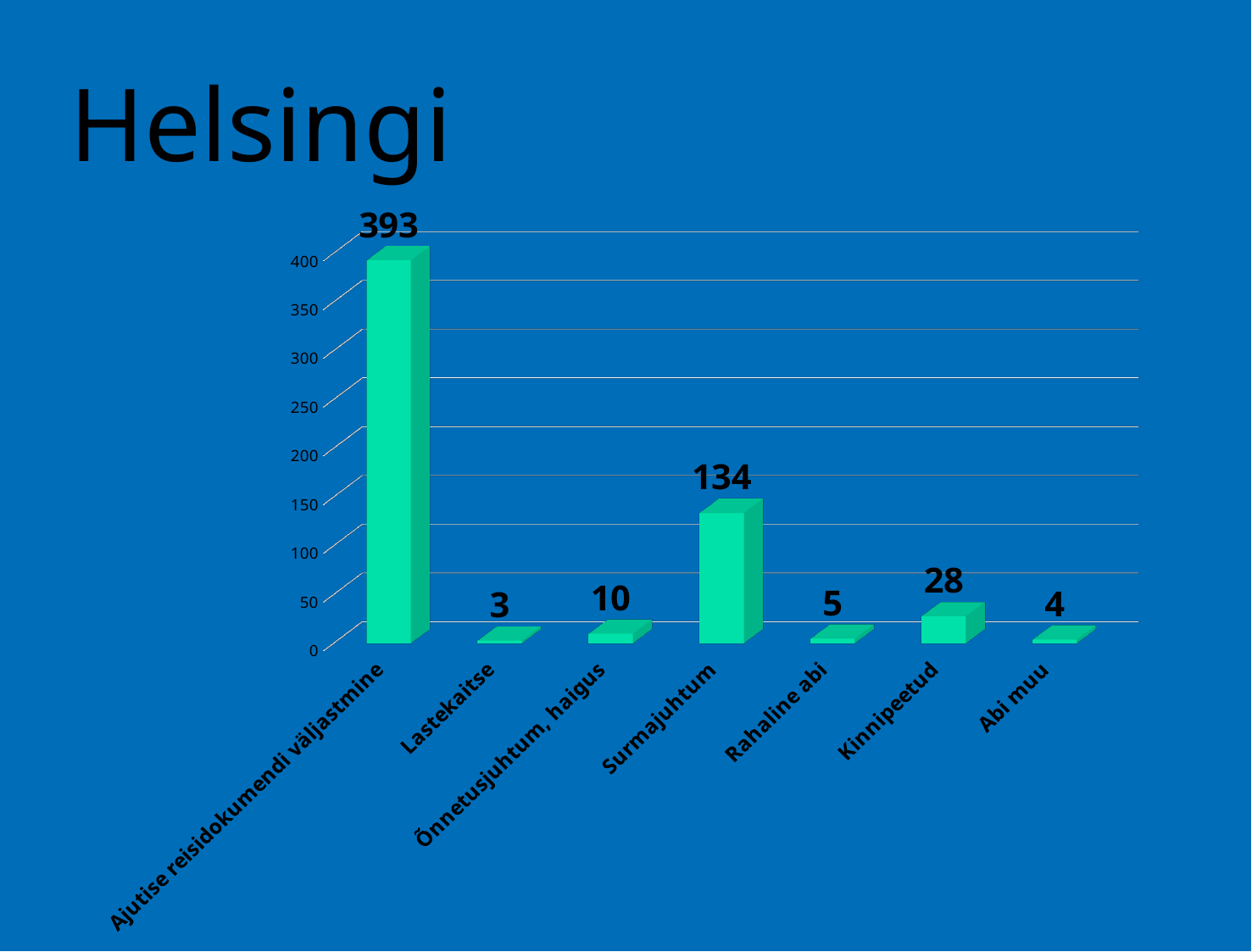
What kind of chart is shown on the slide? bar chart What is the value for Rahaline abi? 5 Which is larger, the value for Kinnipeetud or the value for Õnnetusjuhtum, haigus? Kinnipeetud What is the value for Kinnipeetud? 28 What is the value for Õnnetusjuhtum, haigus? 10 What is the value for Surmajuhtum? 134 How many categories are shown on the x axis? 7 Is the value for Surmajuhtum greater or less than 100? greater Which category has the lowest value? Lastekaitse Which category has the highest value? Ajutise reisidokumendi väljastmine What is the title of the slide? Helsingi What is the difference between the values for Ajutise reisidokumendi väljastmine and Surmajuhtum? 259